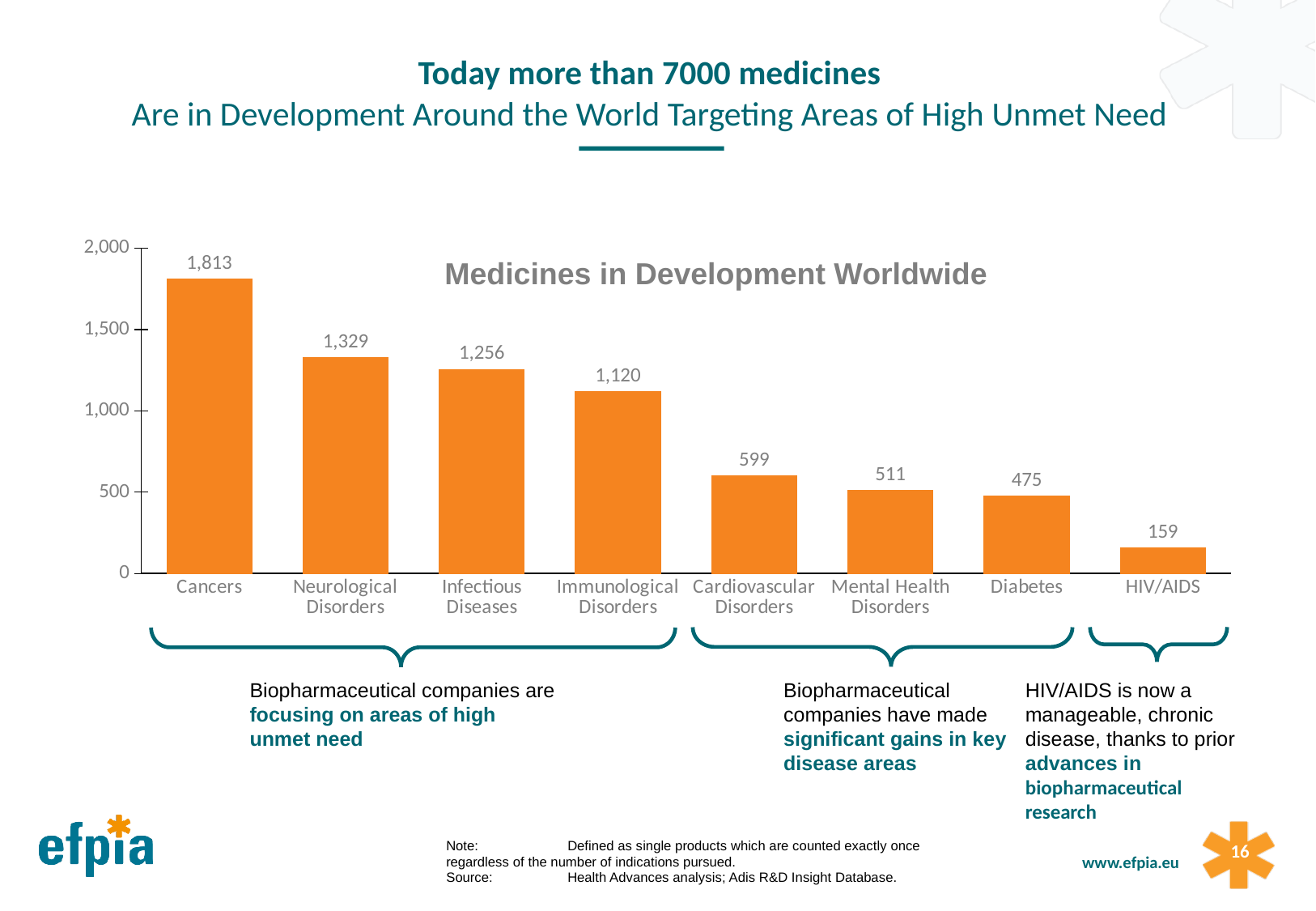
Which category has the highest number of medicines in development? Cancers Which category has the lowest number of medicines in development? HIV/AIDS What is the value for HIV/AIDS? 159 Which is larger, the value for Infectious Diseases or Immunological Disorders? Infectious Diseases Is the value for Cardiovascular Disorders greater or less than 500? greater What kind of chart is shown on the slide? Bar chart How many categories are shown on the x axis of the chart? 8 What is the title of the chart? Medicines in Development Worldwide What is the difference between the values for Cancers and Neurological Disorders? 484 What is the value for Cancers in the Medicines in Development Worldwide chart? 1,813 What is the difference between the values for Mental Health Disorders and Diabetes? 36 How many medicines in development are shown for Cardiovascular Disorders? 599